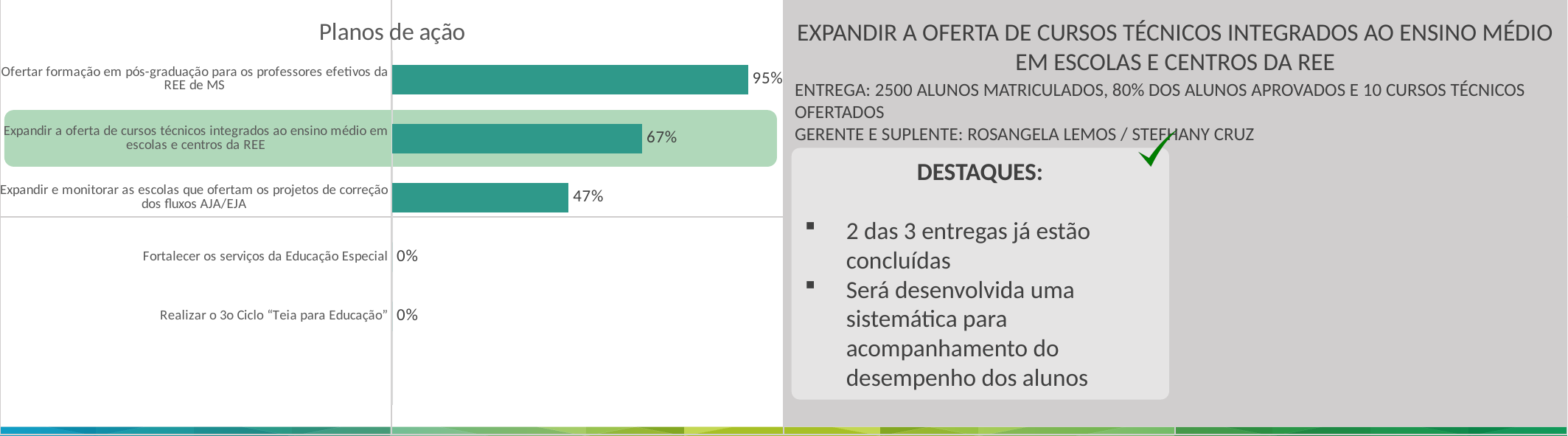
What is the title of the chart? Planos de ação Which category has the highest value? Ofertar formação em pós-graduação para os professores efetivos da REE de MS What is the difference between the values for "Ofertar formação em pós-graduação para os professores efetivos da REE de MS" and "Expandir a oferta de cursos técnicos integrados ao ensino médio em escolas e centros da REE"? 28% What is the value for "Expandir e monitorar as escolas que ofertam os projetos de correção dos fluxos AJA/EJA"? 47% Which is larger: the value for "Expandir a oferta de cursos técnicos integrados ao ensino médio em escolas e centros da REE" or for "Expandir e monitorar as escolas que ofertam os projetos de correção dos fluxos AJA/EJA"? Expandir a oferta de cursos técnicos integrados ao ensino médio em escolas e centros da REE How many categories have a value of 0%? 2 What is the value for "Expandir a oferta de cursos técnicos integrados ao ensino médio em escolas e centros da REE"? 67% What is the value for "Fortalecer os serviços da Educação Especial"? 0% What is the value for "Ofertar formação em pós-graduação para os professores efetivos da REE de MS"? 95% How many categories does the chart show? 5 What type of chart is shown on the slide? bar chart What is the difference between the values for "Expandir a oferta de cursos técnicos integrados ao ensino médio em escolas e centros da REE" and "Expandir e monitorar as escolas que ofertam os projetos de correção dos fluxos AJA/EJA"? 20%